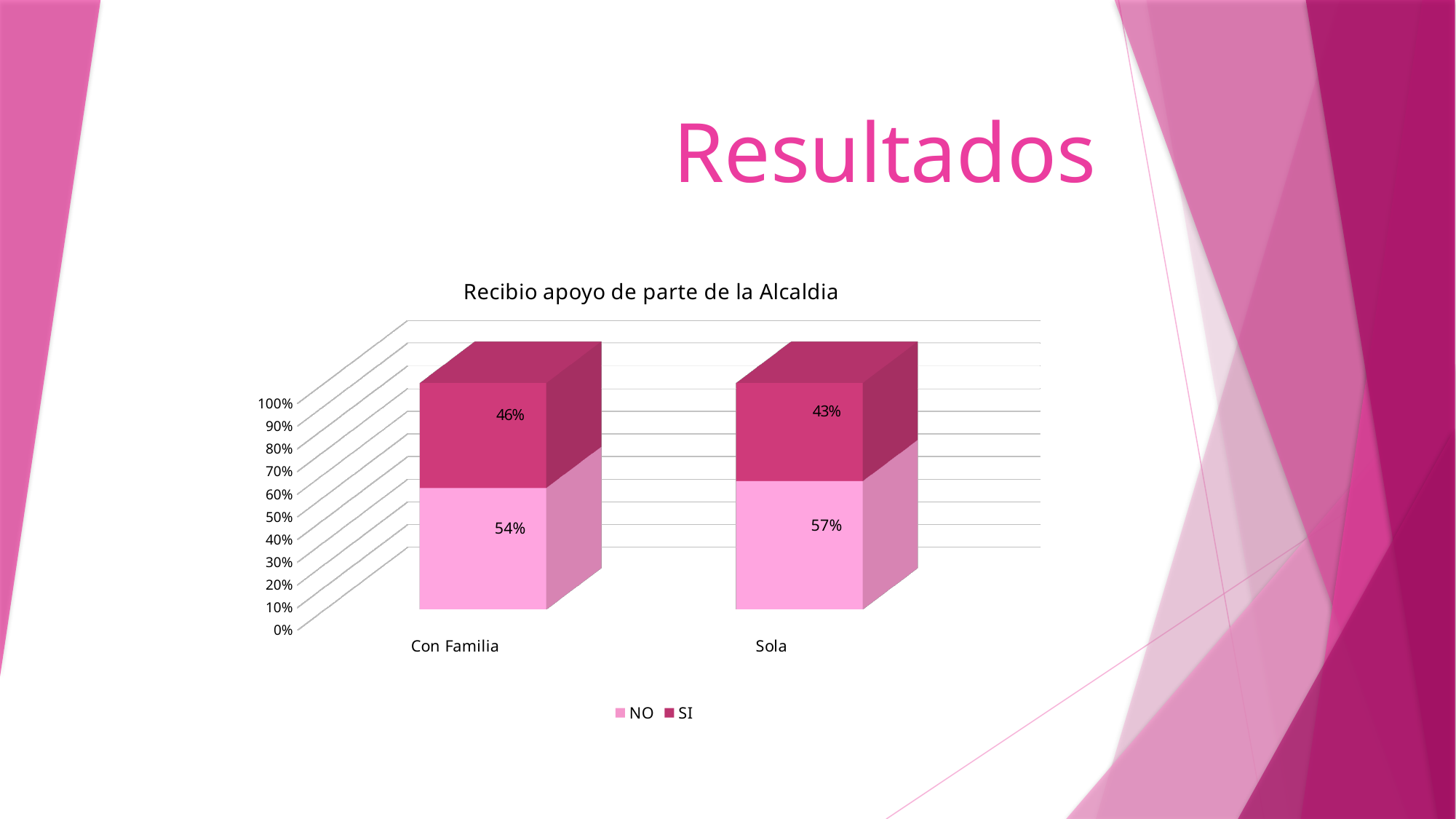
What is the value for NO in the Sola category? 57% How many series does the legend list? 2 What is the total of the stacked bar for Sola? 100% What is the value for NO in the Con Familia category? 54% What is the value for SI in the Con Familia category? 46% How many categories are shown on the x axis? 2 What is the difference between the NO and SI values in the Con Familia category? 8% What is the title of the chart? Recibio apoyo de parte de la Alcaldia Which category has the higher value for NO, Con Familia or Sola? Sola What is the difference between the SI values for Con Familia and Sola? 3% Which category has the lower value for SI? Sola What is the value for SI in the Sola category? 43%